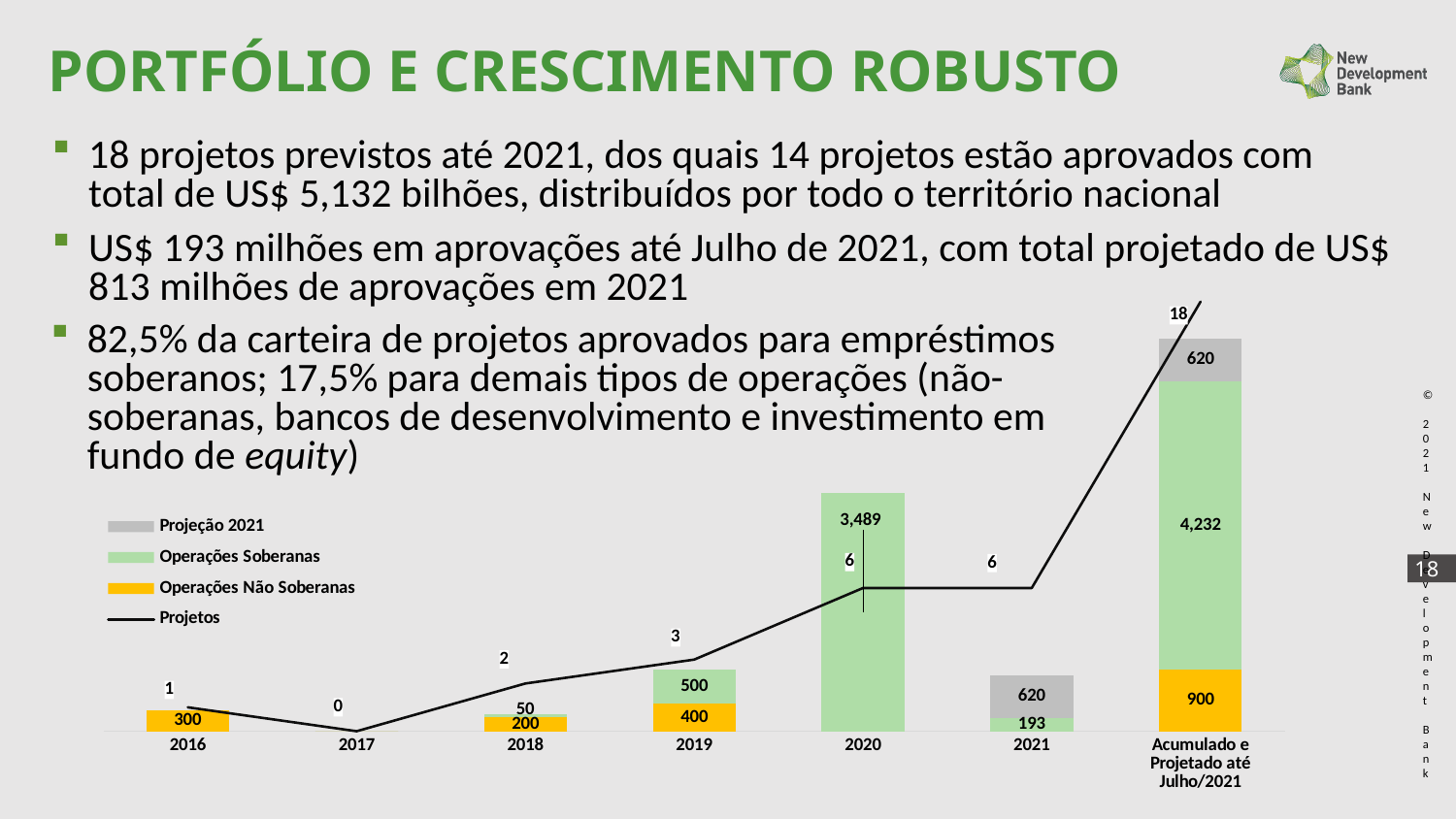
What is the total of the stacked bar for 2018? 250 What is the value of Operações Não Soberanas for 2016? 300 What is the Projeção 2021 value for 2021? 620 What is the Projetos value for 2019? 3 How many series does the legend list? 4 Which category has the highest Projetos value? Acumulado e Projetado até Julho/2021 Which is larger: Operações Soberanas in 2020 or Operações Soberanas in 2021? 2020 What is the value of Operações Soberanas for 'Acumulado e Projetado até Julho/2021'? 4,232 What is the difference between Operações Soberanas and Operações Não Soberanas in 2019? 100 What is the value of Operações Soberanas for 2020? 3,489 What colour represents Operações Não Soberanas in the legend? Yellow Which year has the lowest Projetos value? 2017